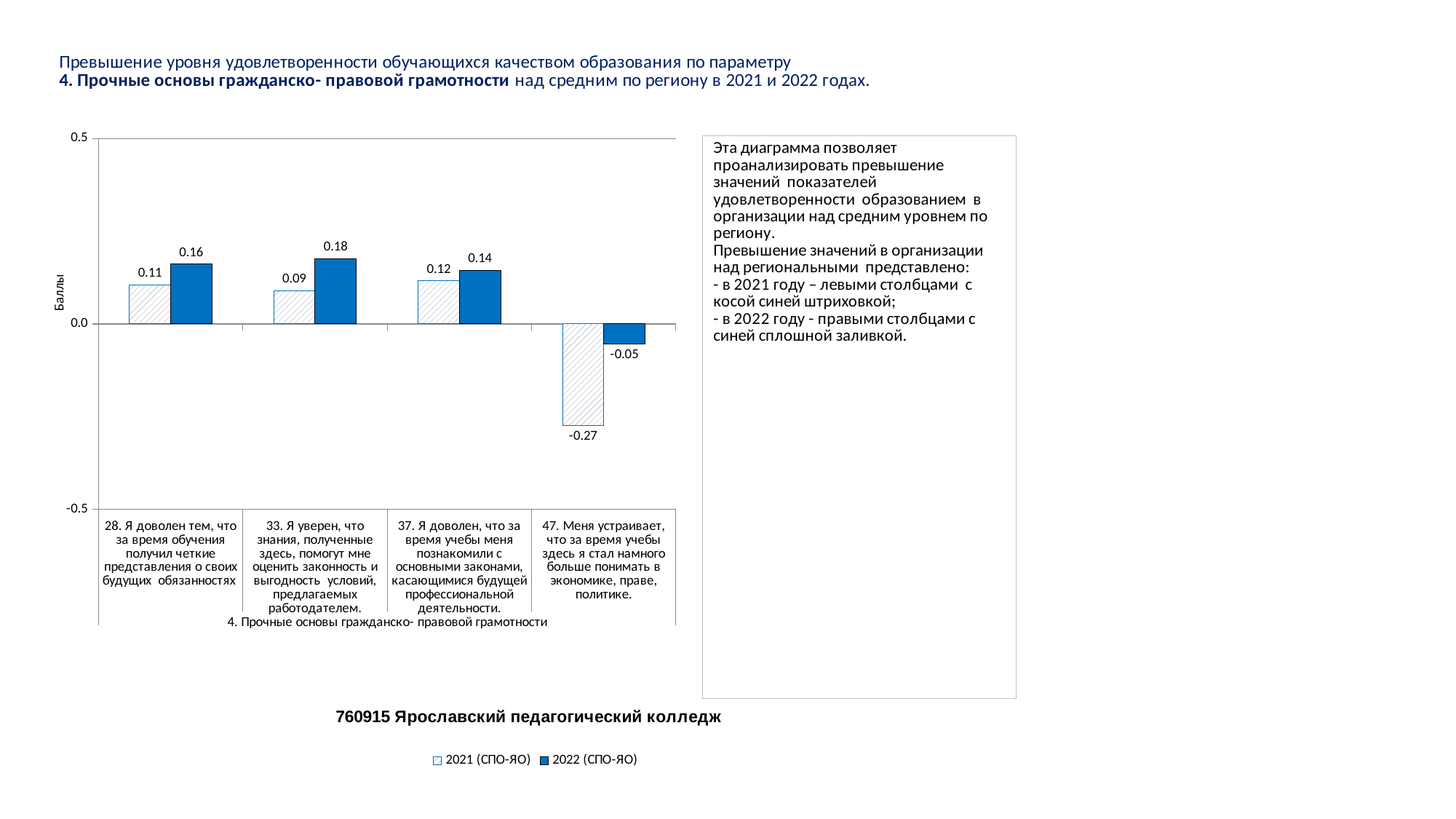
What is the 2022 (СПО-ЯО) value for item 37 ("Я доволен, что за время учебы меня познакомили с основными законами, касающимися будущей профессиональной деятельности")? 0.14 How many items (categories) are shown on the x axis of the chart? 4 Which item has the highest 2022 (СПО-ЯО) value? 33. Я уверен, что знания, полученные здесь, помогут мне оценить законность и выгодность условий, предлагаемых работодателем. What is the 2021 (СПО-ЯО) value for item 28 ("Я доволен тем, что за время обучения получил четкие представления о своих будущих обязанностях")? 0.11 What type of chart is shown on the slide? Bar chart For item 47, which is larger: the 2021 value or the 2022 value? 2022 (СПО-ЯО) Which item has the lowest 2021 (СПО-ЯО) value? 47. Меня устраивает, что за время учебы здесь я стал намного больше понимать в экономике, праве, политике. What is the label of the vertical axis of the chart? Баллы What is the 2022 (СПО-ЯО) value for item 33 ("Я уверен, что знания, полученные здесь, помогут мне оценить законность и выгодность условий, предлагаемых работодателем")? 0.18 What is the 2021 (СПО-ЯО) value for item 47 ("Меня устраивает, что за время учебы здесь я стал намного больше понимать в экономике, праве, политике")? -0.27 How many series does the chart legend list? 2 What is the difference between the 2022 and 2021 values for item 33? 0.09